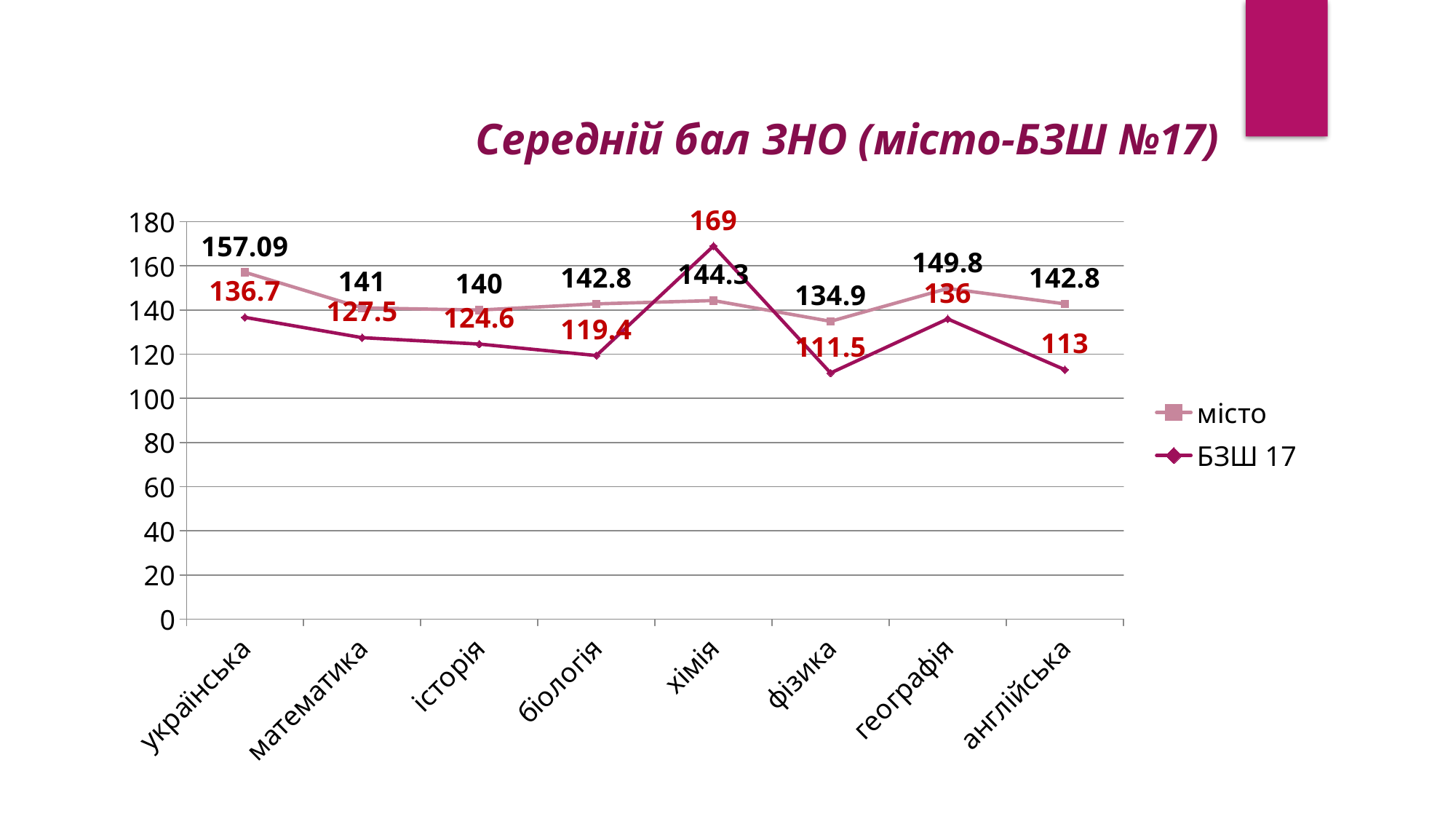
Which is larger for хімія: the місто value or the БЗШ 17 value? БЗШ 17 What is the value for БЗШ 17 for біологія? 119.4 How many subjects are shown on the x axis? 8 What is the value for БЗШ 17 for хімія? 169 What kind of chart is shown on the slide? line chart How many series does the legend list? 2 For which subject is the БЗШ 17 value the highest? хімія What is the value for місто for українська? 157.09 What is the difference between the місто and БЗШ 17 values for математика? 13.5 For which subject is the місто value the lowest? фізика For which subject is the БЗШ 17 value the lowest? фізика What is the value for місто for географія? 149.8